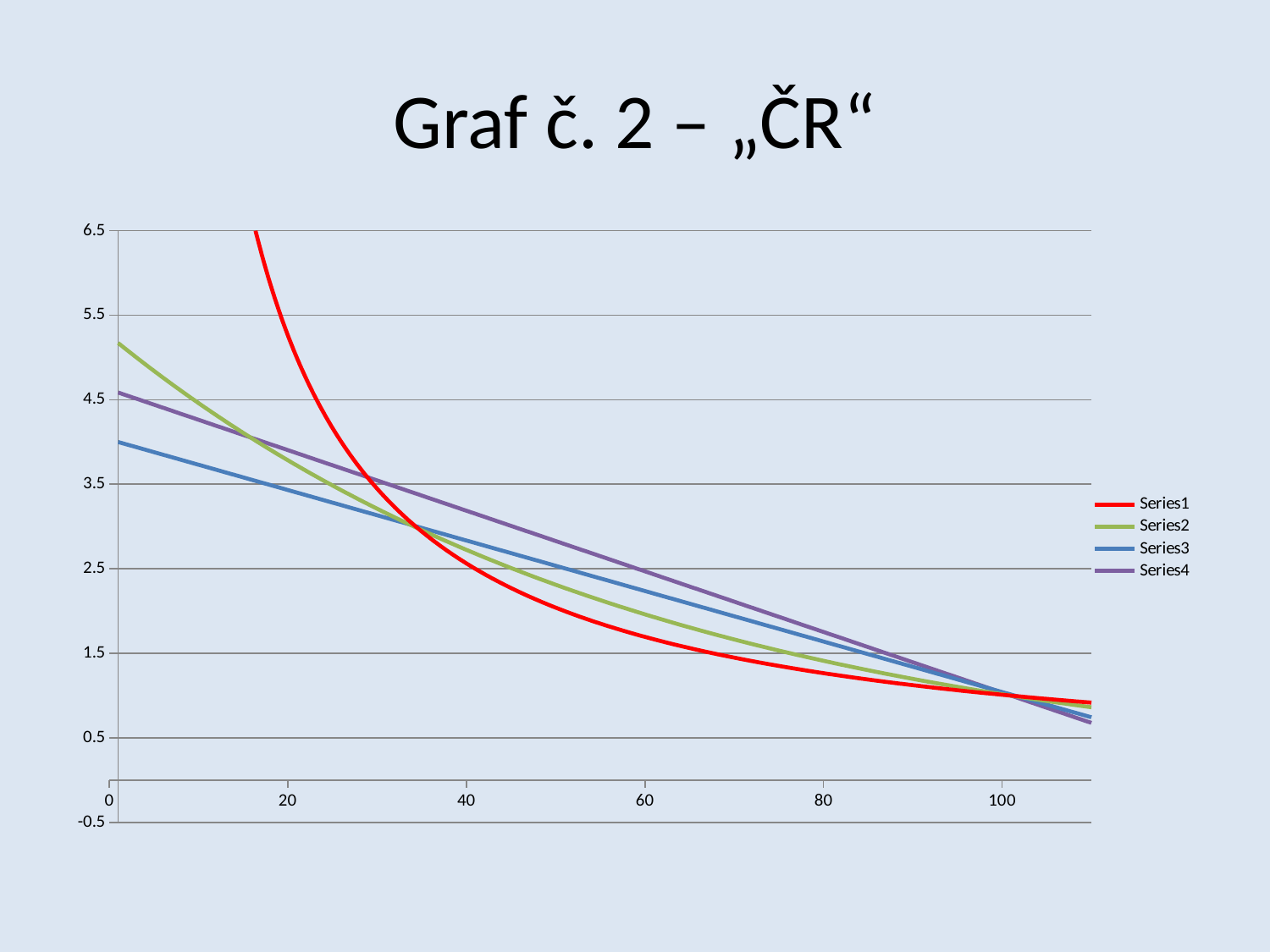
At x = 20, which is larger: the value of Series1 or the value of Series4? Series1 What kind of chart is shown on the slide? line chart How many series does the legend list? 4 Do the values of Series4 rise or fall along the x axis? fall Is the value of Series2 at x = 0 greater or less than 4.5? greater What is the title of the chart? Graf č. 2 – „ČR“ Is the value of Series1 at x = 80 greater or less than 1.5? less Which colour is used for Series1 in the chart? red Which series has the highest value at x = 0? Series1 Which series has the lowest value at x = 0? Series3 At x = 60, which is larger: the value of Series4 or the value of Series1? Series4 Do the values of Series1 rise or fall as the x axis increases? fall